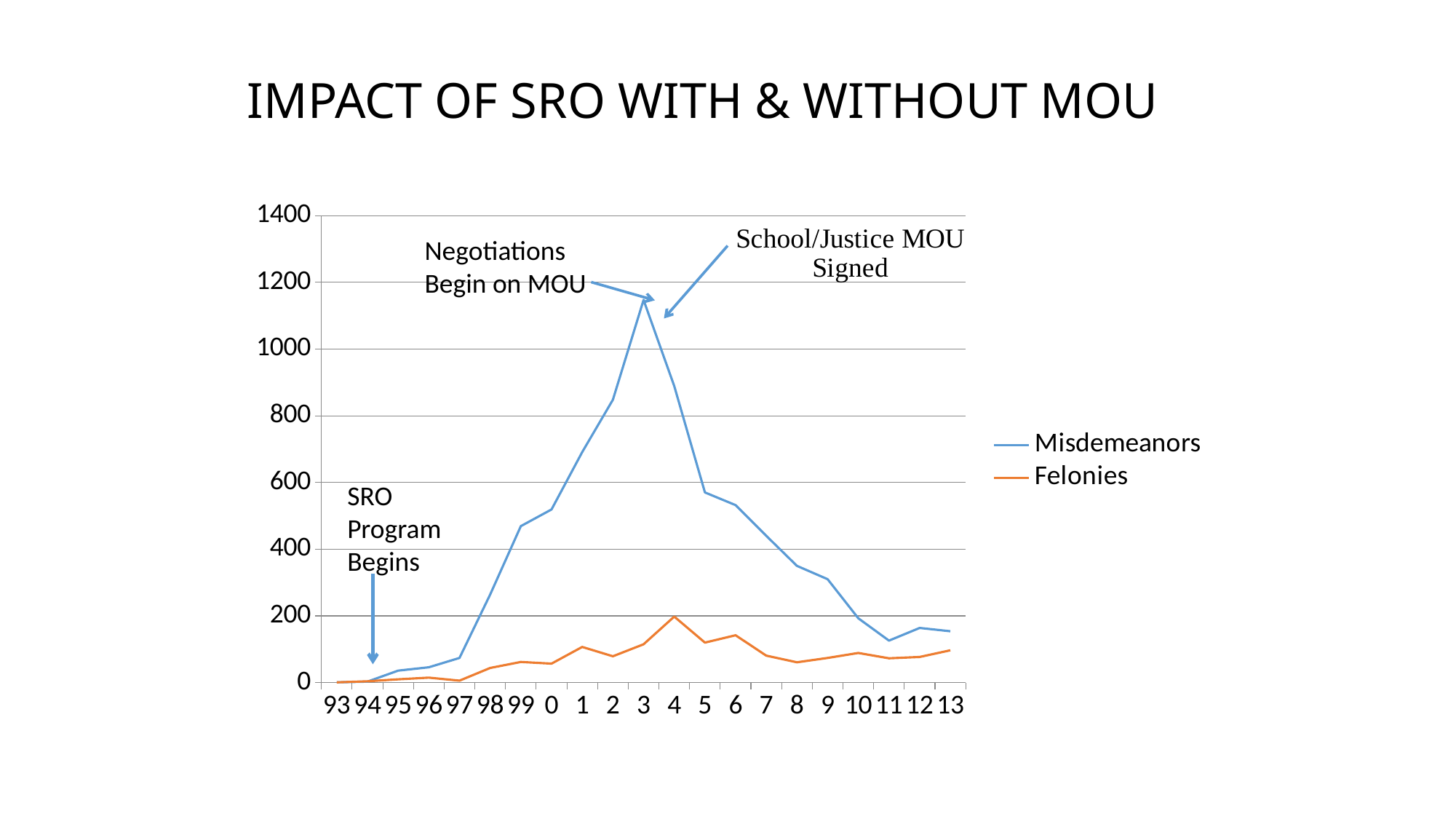
Is the value for Misdemeanors at 3 greater or less than 1000? greater At which x-axis label does the Misdemeanors series reach its highest value? 3 Do the Misdemeanors values rise or fall between 3 and 10 on the x axis? fall How many points are plotted along the x axis for each series? 21 Is the value for Misdemeanors at 2 greater or less than 800? greater How many series does the legend list? 2 Is the value for Felonies at 1 greater or less than 200? less What is the title of the slide? IMPACT OF SRO WITH & WITHOUT MOU Which series has the larger value at 5, Misdemeanors or Felonies? Misdemeanors What kind of chart is shown on the slide? line chart At which x-axis label does the Felonies series reach its highest value? 4